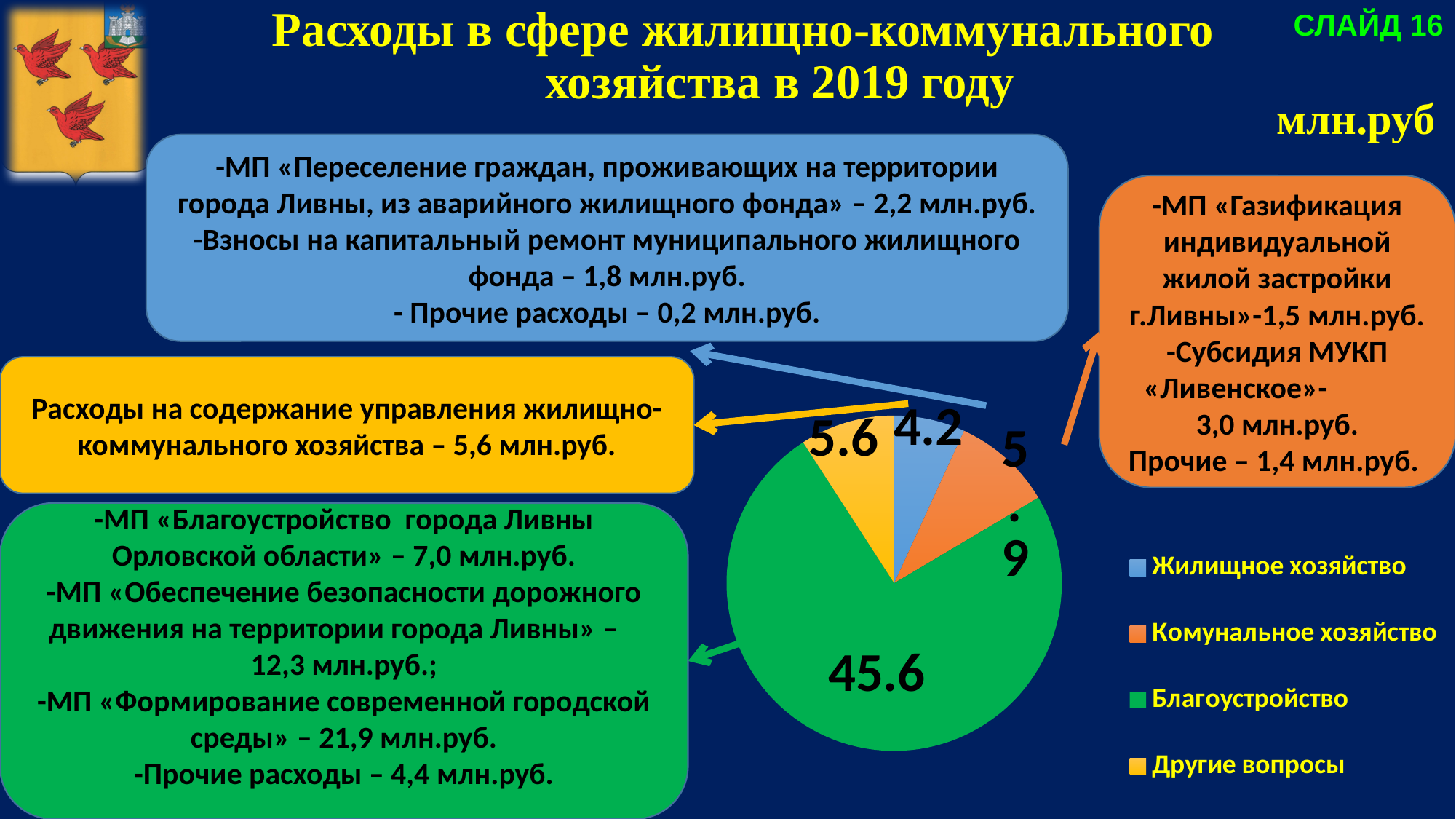
What is the value for Благоустройство in the pie chart? 45.6 What is the value for Коммунальное хозяйство in the pie chart? 5.9 Which category has the largest slice in the pie chart? Благоустройство What is the difference between the values for Благоустройство and Другие вопросы? 40 Which category has the smallest slice in the pie chart? Жилищное хозяйство What is the value for Другие вопросы in the pie chart? 5.6 What is the value for Жилищное хозяйство in the pie chart? 4.2 How many slices does the pie chart have? 4 What is the difference between the values for Коммунальное хозяйство and Жилищное хозяйство? 1.7 What kind of chart is shown on the slide? Pie chart Which is larger, the value for Благоустройство or the value for Жилищное хозяйство? Благоустройство Which colour represents Другие вопросы in the pie chart legend? Yellow